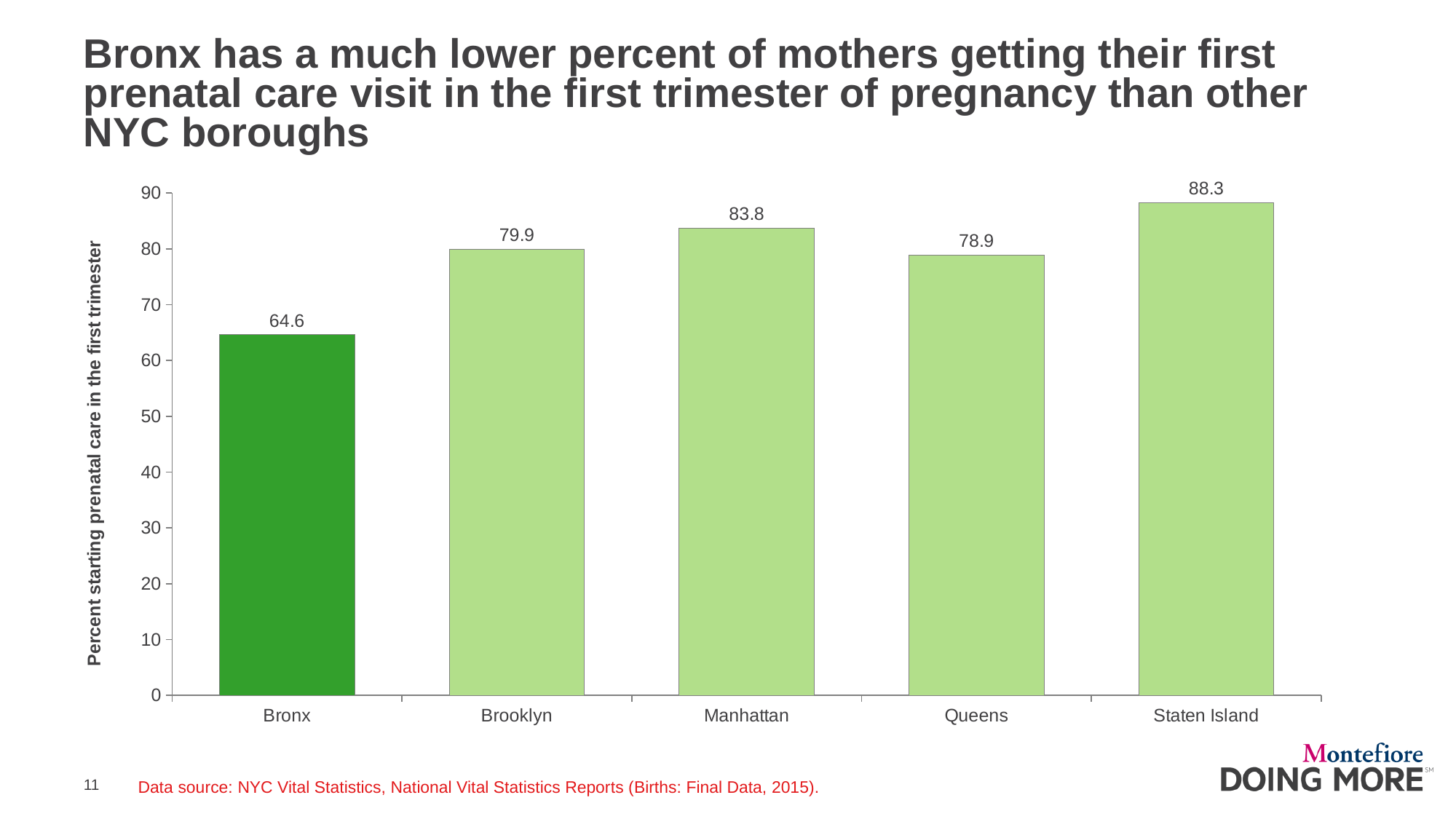
Is the value for Manhattan greater or less than 80? greater Which is larger, the value for Brooklyn or the value for Queens? Brooklyn What is the label of the vertical axis? Percent starting prenatal care in the first trimester Which borough has the highest percent starting prenatal care in the first trimester? Staten Island What is the value for Queens? 78.9 What is the value for Bronx? 64.6 What is the difference between the values for Manhattan and Brooklyn? 3.9 How many boroughs are shown on the chart? 5 What kind of chart is shown on the slide? bar chart What is the difference between the values for Staten Island and Bronx? 23.7 What is the value for Staten Island? 88.3 Which borough has the lowest percent starting prenatal care in the first trimester? Bronx